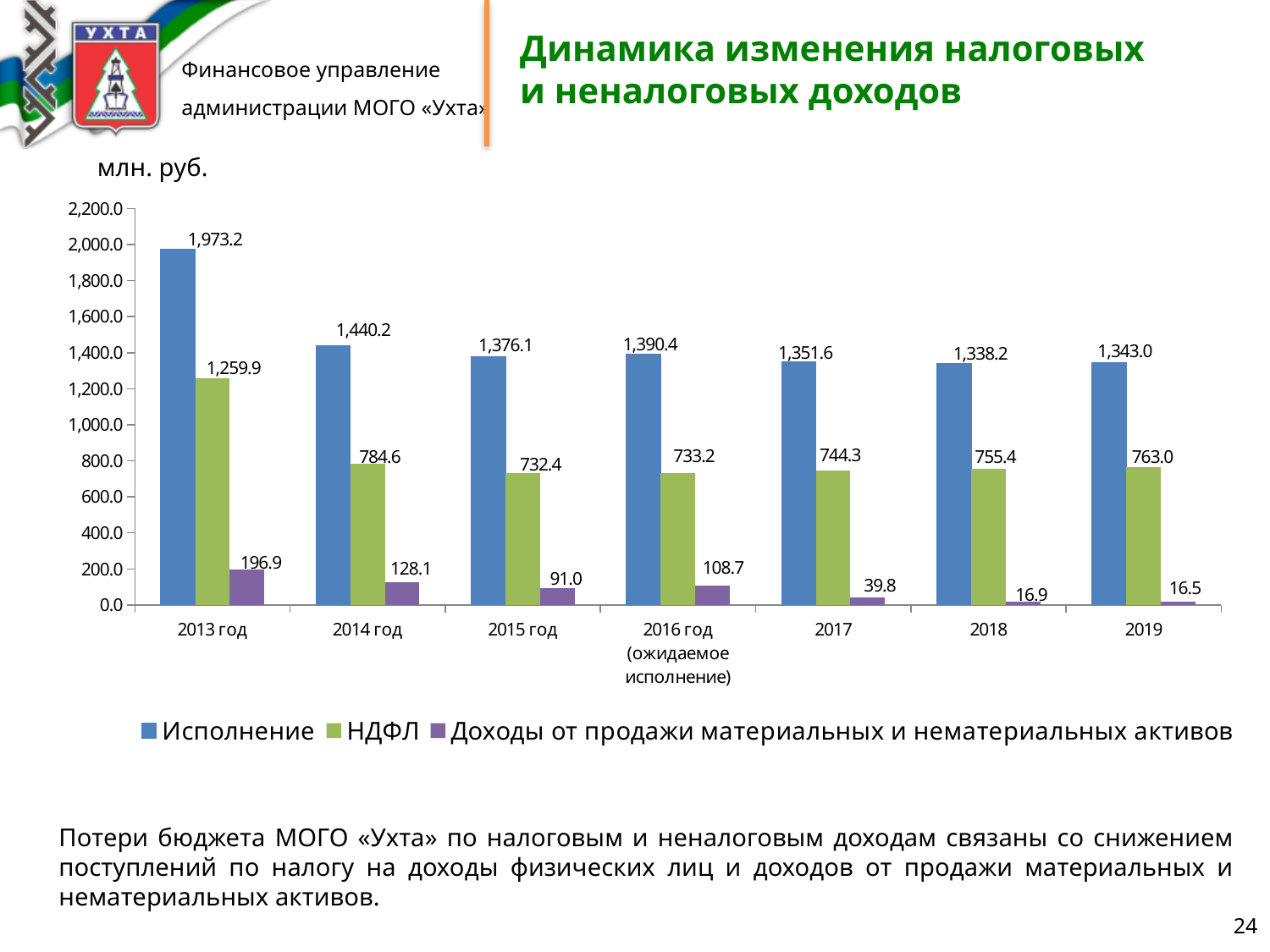
How many year categories are shown on the x axis? 7 In which year is the Исполнение value highest? 2013 год What is the value of НДФЛ for 2019? 763.0 What is the value of Доходы от продажи материальных и нематериальных активов for 2016 год (ожидаемое исполнение)? 108.7 How many series does the legend list? 3 What is the value of Исполнение for 2013 год? 1,973.2 What is the difference between the Исполнение values for 2013 год and 2014 год? 533.0 In which year is the Доходы от продажи материальных и нематериальных активов value lowest? 2019 Which is larger, the НДФЛ value for 2014 год or for 2015 год? 2014 год What kind of chart is shown on the slide? Bar chart What unit is stated above the chart? млн. руб. Does the Доходы от продажи материальных и нематериальных активов series generally rise or fall from 2013 год to 2019? Fall